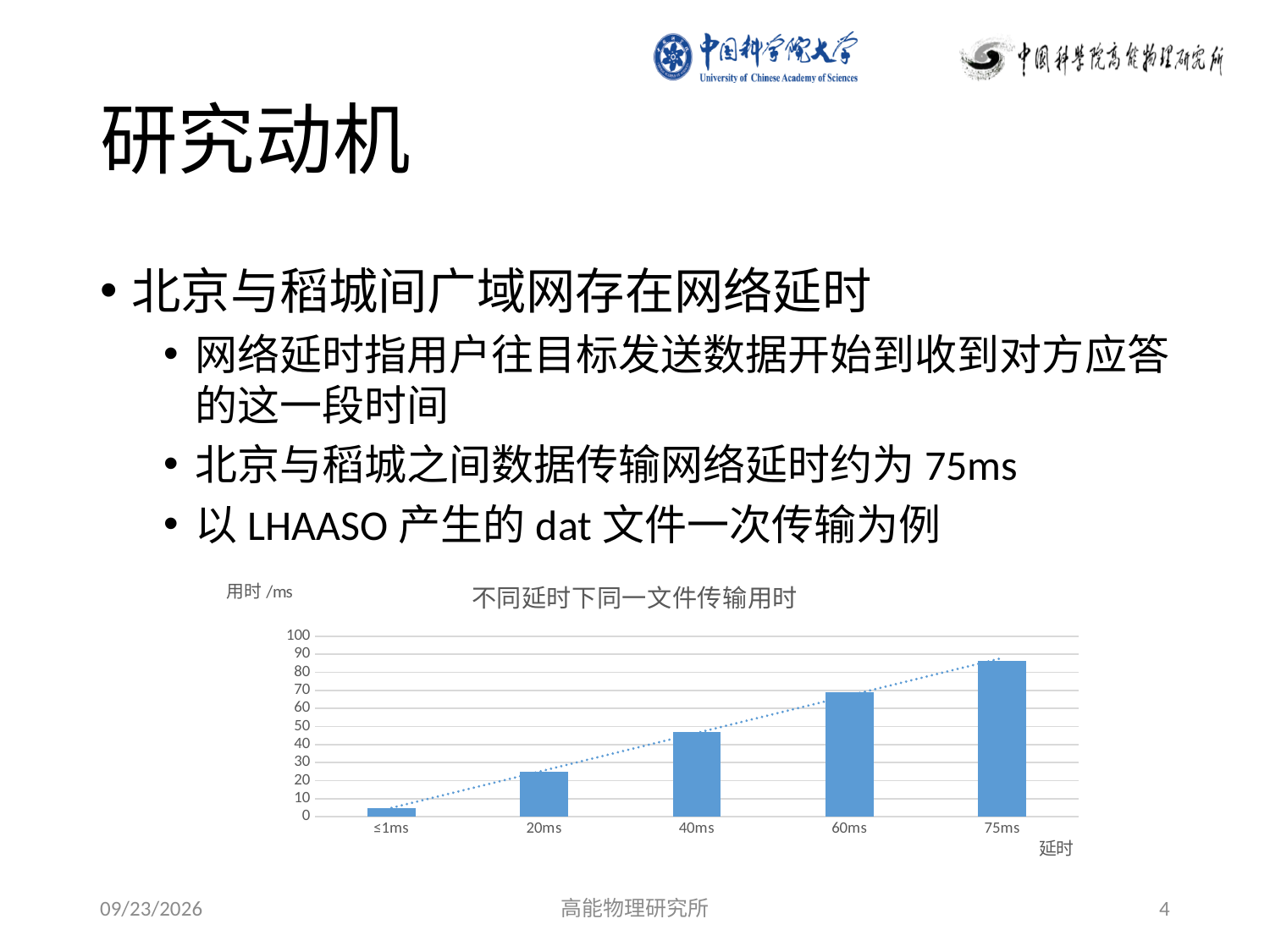
Do the values rise or fall as the delay increases along the x axis? rise Is the value for 60ms greater or less than 60? greater Which is larger, the value for 60ms or the value for 40ms? 60ms Is the value for 20ms greater or less than 30? less How many categories are shown on the x axis of the chart? 5 What is the title of the chart? 不同延时下同一文件传输用时 Which category has the lowest bar in the chart? ≤1ms What kind of chart is shown on the slide? bar chart Which category has the highest bar in the chart? 75ms Is the value for 75ms greater or less than 80? greater